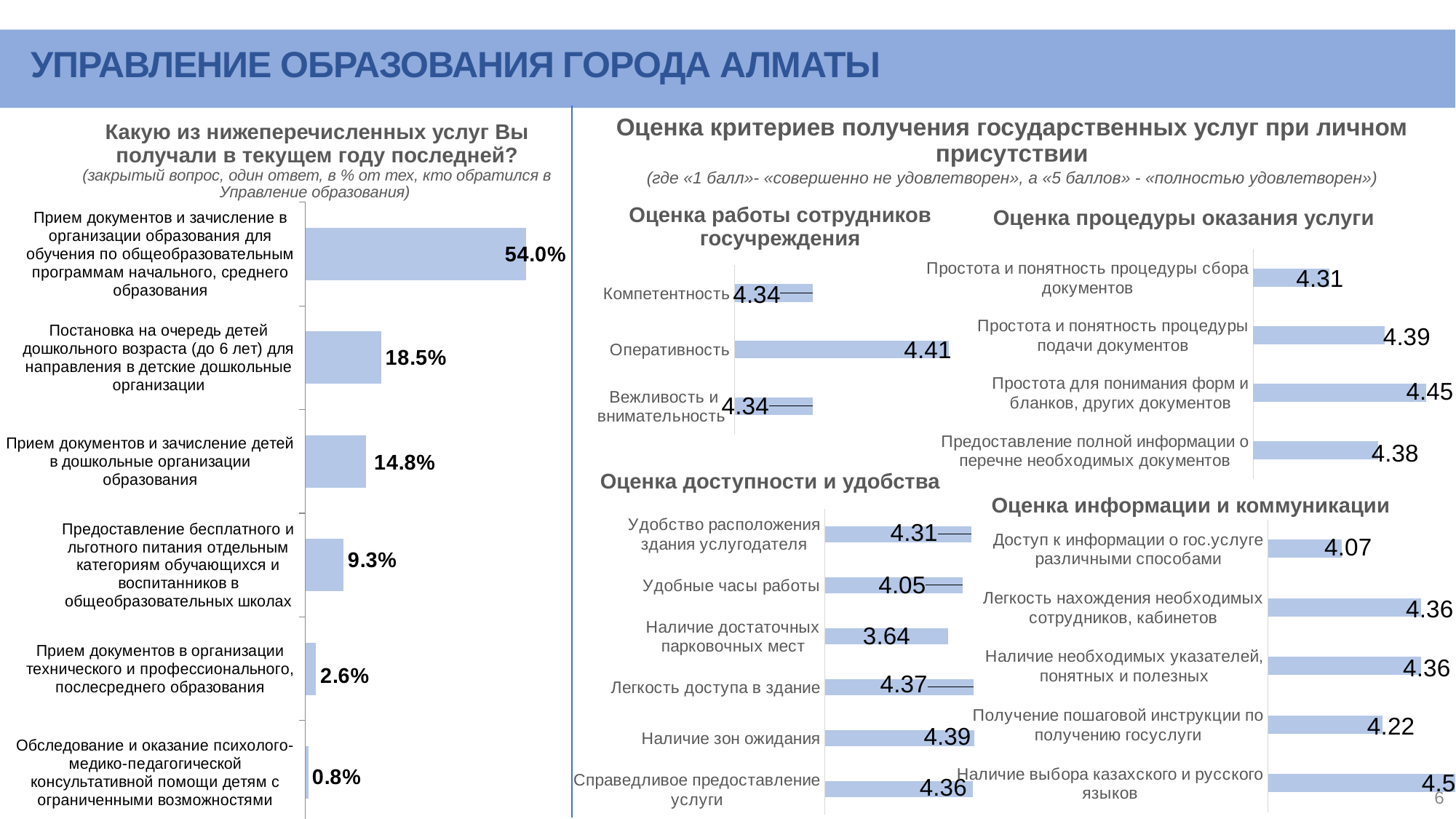
On the chart "Оценка процедуры оказания услуги", which category has the highest value? Простота для понимания форм и бланков, других документов On the chart "Оценка доступности и удобства", which category has the lowest value? Наличие достаточных парковочных мест On the chart "Оценка процедуры оказания услуги", what is the value for "Предоставление полной информации о перечне необходимых документов"? 4.38 What type of chart is "Оценка работы сотрудников госучреждения"? Bar chart On the chart "Оценка информации и коммуникации", what is the value for "Получение пошаговой инструкции по получению госуслуги"? 4.22 How many categories are shown on the chart "Какую из нижеперечисленных услуг Вы получали в текущем году последней?"? 6 On the chart "Оценка работы сотрудников госучреждения", what is the value for "Оперативность"? 4.41 On the chart "Какую из нижеперечисленных услуг Вы получали в текущем году последней?", which category has the lowest value? Обследование и оказание психолого-медико-педагогической консультативной помощи детям с ограниченными возможностями On the chart "Какую из нижеперечисленных услуг Вы получали в текущем году последней?", which category has the highest value? Прием документов и зачисление в организации образования для обучения по общеобразовательным программам начального, среднего образования On the chart "Какую из нижеперечисленных услуг Вы получали в текущем году последней?", what is the difference between the values for "Прием документов и зачисление детей в дошкольные организации образования" and "Предоставление бесплатного и льготного питания..."? 5.5% On the chart "Оценка доступности и удобства", which is larger: the value for "Легкость доступа в здание" or the value for "Удобные часы работы"? Легкость доступа в здание On the chart "Какую из нижеперечисленных услуг Вы получали в текущем году последней?", what is the value for "Постановка на очередь детей дошкольного возраста (до 6 лет) для направления в детские дошкольные организации"? 18.5%